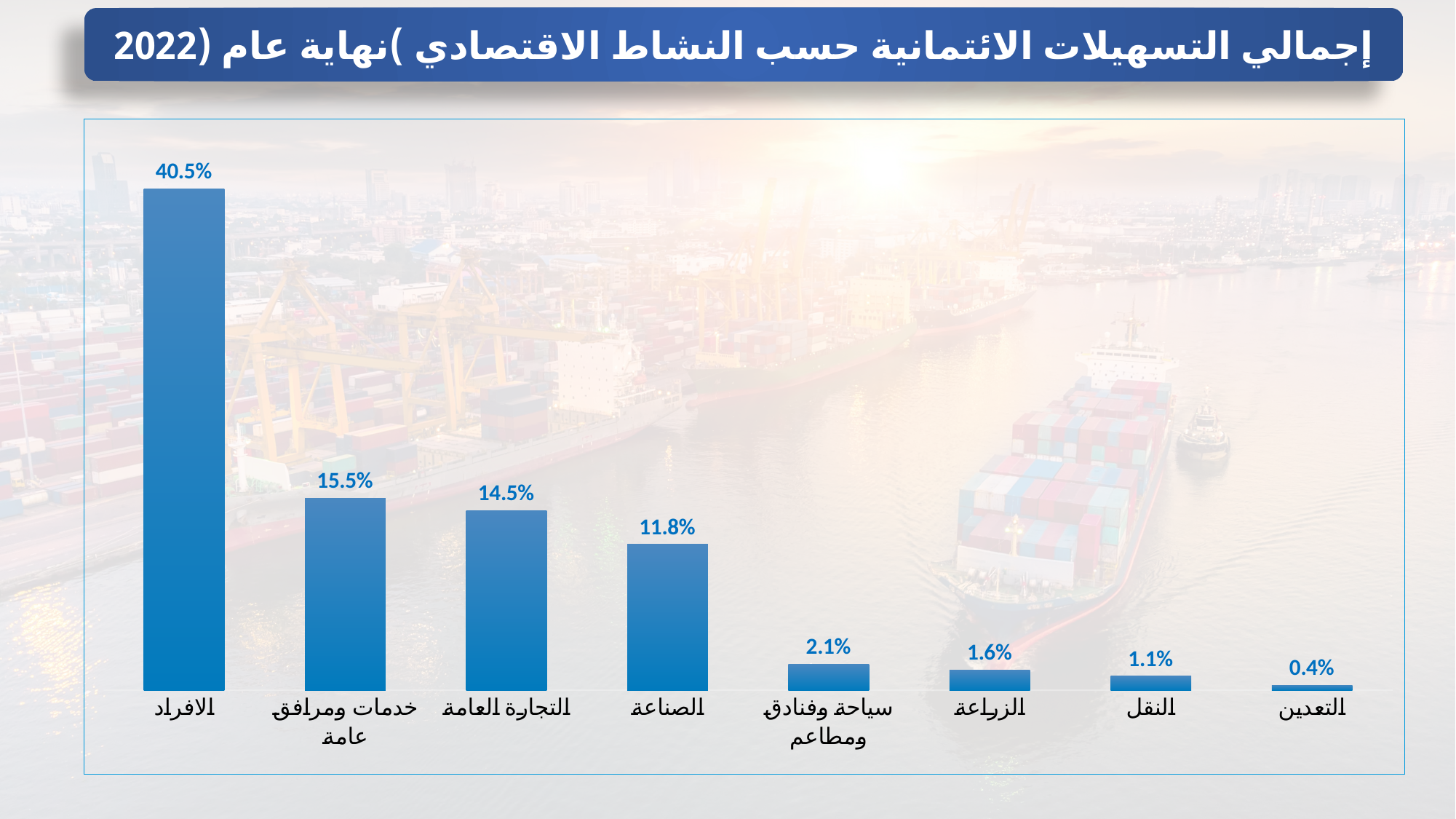
Which category has the lowest value? التعدين Which is larger, the value for الزراعة or the value for النقل? الزراعة What is the difference between the values for الافراد and الصناعة? 28.7% What kind of chart is shown on the slide? Bar chart What is the value for الصناعة? 11.8% How many categories are shown in the chart? 8 What is the value for التعدين? 0.4% Which category has the highest value? الافراد What is the difference between the values for خدمات ومرافق عامة and التجارة العامة? 1.0% Do the values rise or fall moving from left to right along the x axis? Fall What is the value for الافراد? 40.5% What is the value for سياحة وفنادق ومطاعم? 2.1%